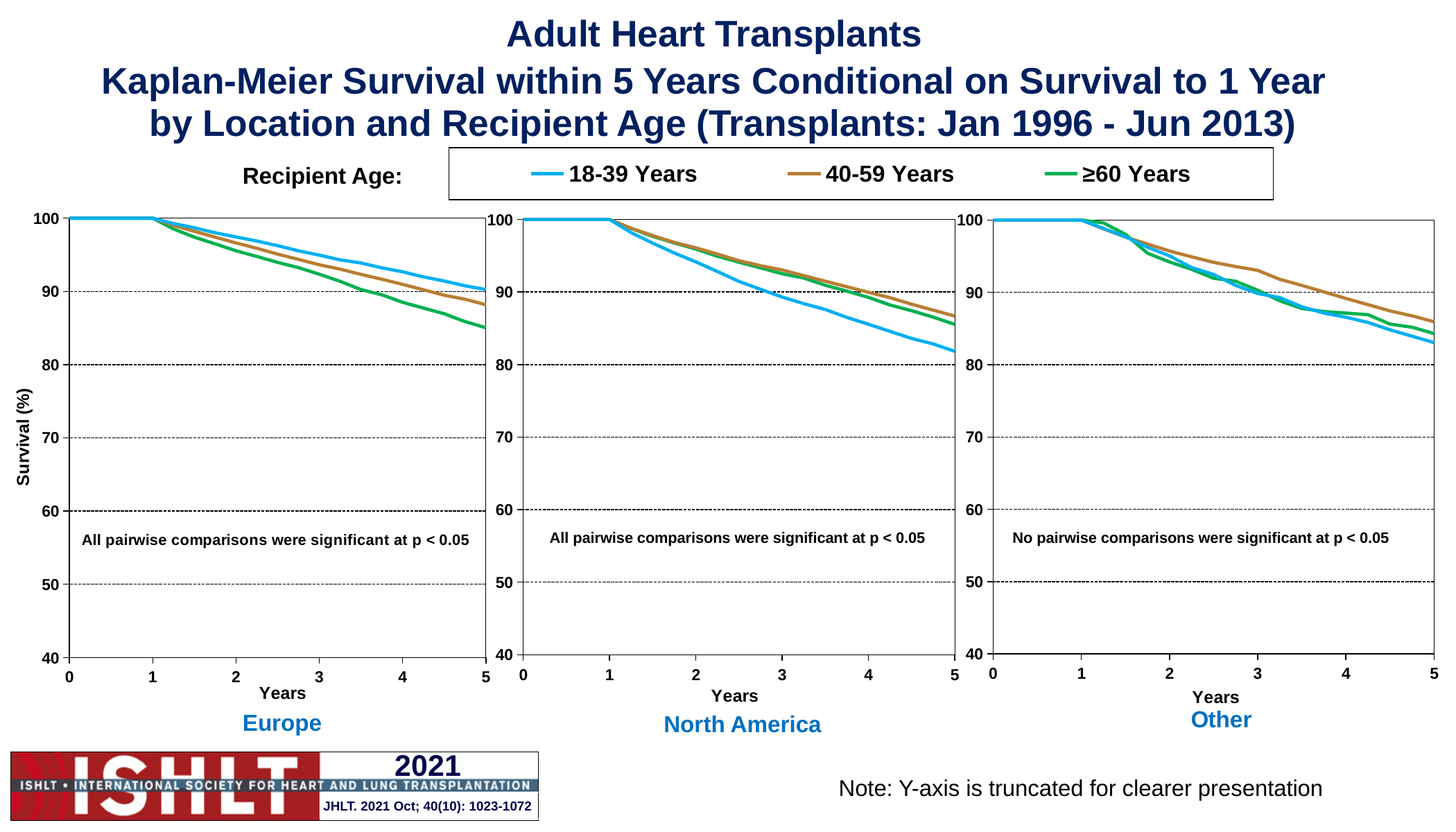
In the Other chart, do the survival curves rise or fall from year 1 to year 5? Fall In the North America chart, is the 5-year survival for 18-39 Years greater or less than 90? less In the Europe chart, which recipient age group has the lowest survival at 5 years? ≥60 Years In the Europe chart, is the 5-year survival for ≥60 Years greater or less than 90? less In the Europe chart, which is higher at 5 years: 18-39 Years or ≥60 Years? 18-39 Years What kind of chart is used in the Europe panel? Line chart In the Europe chart, which recipient age group has the highest survival at 5 years? 18-39 Years How many separate charts (location panels) are shown on the slide? 3 In the North America chart, is the 5-year survival for 18-39 Years greater or less than 80? greater How many series does the legend list? 3 In the North America chart, which recipient age group has the lowest survival at 5 years? 18-39 Years What does the annotation in the Other chart say about pairwise comparisons? No pairwise comparisons were significant at p < 0.05